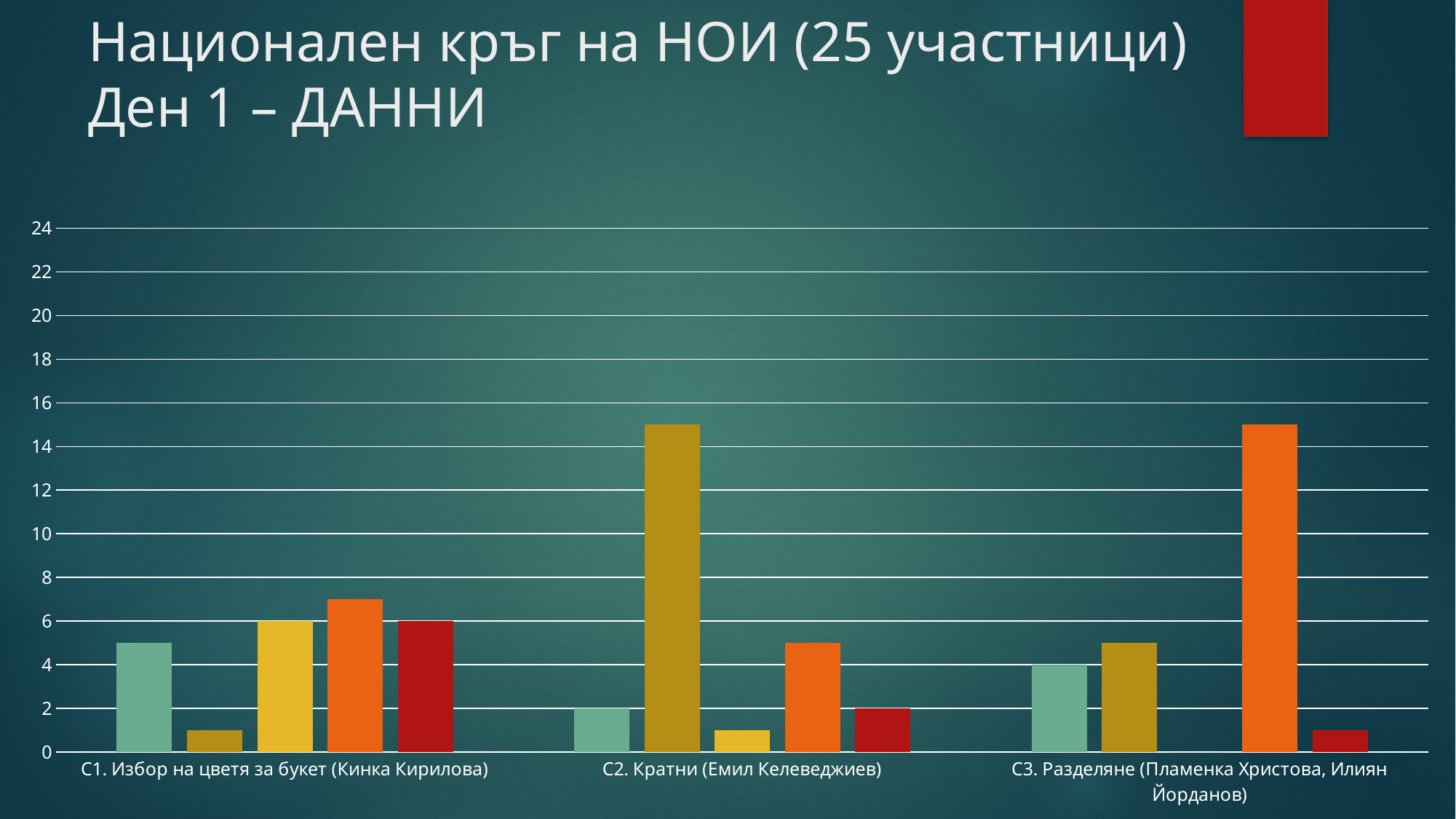
What is the value of the teal bar for "C2. Кратни (Емил Келеведжиев)"? 2 Is the value of the dark gold bar for "C2. Кратни (Емил Келеведжиев)" greater or less than 14? greater What is the highest value shown on the vertical axis of the chart? 24 Which bar is the tallest in the category "C3. Разделяне (Пламенка Христова, Илиян Йорданов)"? the orange bar What is the value of the teal bar for "C3. Разделяне (Пламенка Христова, Илиян Йорданов)"? 4 Which bar is the shortest in the category "C1. Избор на цветя за букет (Кинка Кирилова)"? the dark gold bar Is the value of the orange bar for "C1. Избор на цветя за букет (Кинка Кирилова)" greater or less than 8? less Which is larger: the orange bar for "C2. Кратни (Емил Келеведжиев)" or the orange bar for "C3. Разделяне (Пламенка Христова, Илиян Йорданов)"? C3. Разделяне (Пламенка Христова, Илиян Йорданов) How many categories are shown on the x axis of the chart? 3 How many bars are plotted for the category "C2. Кратни (Емил Келеведжиев)"? 5 What kind of chart is shown on the slide? bar chart What is the value of the yellow bar for "C1. Избор на цветя за букет (Кинка Кирилова)"? 6